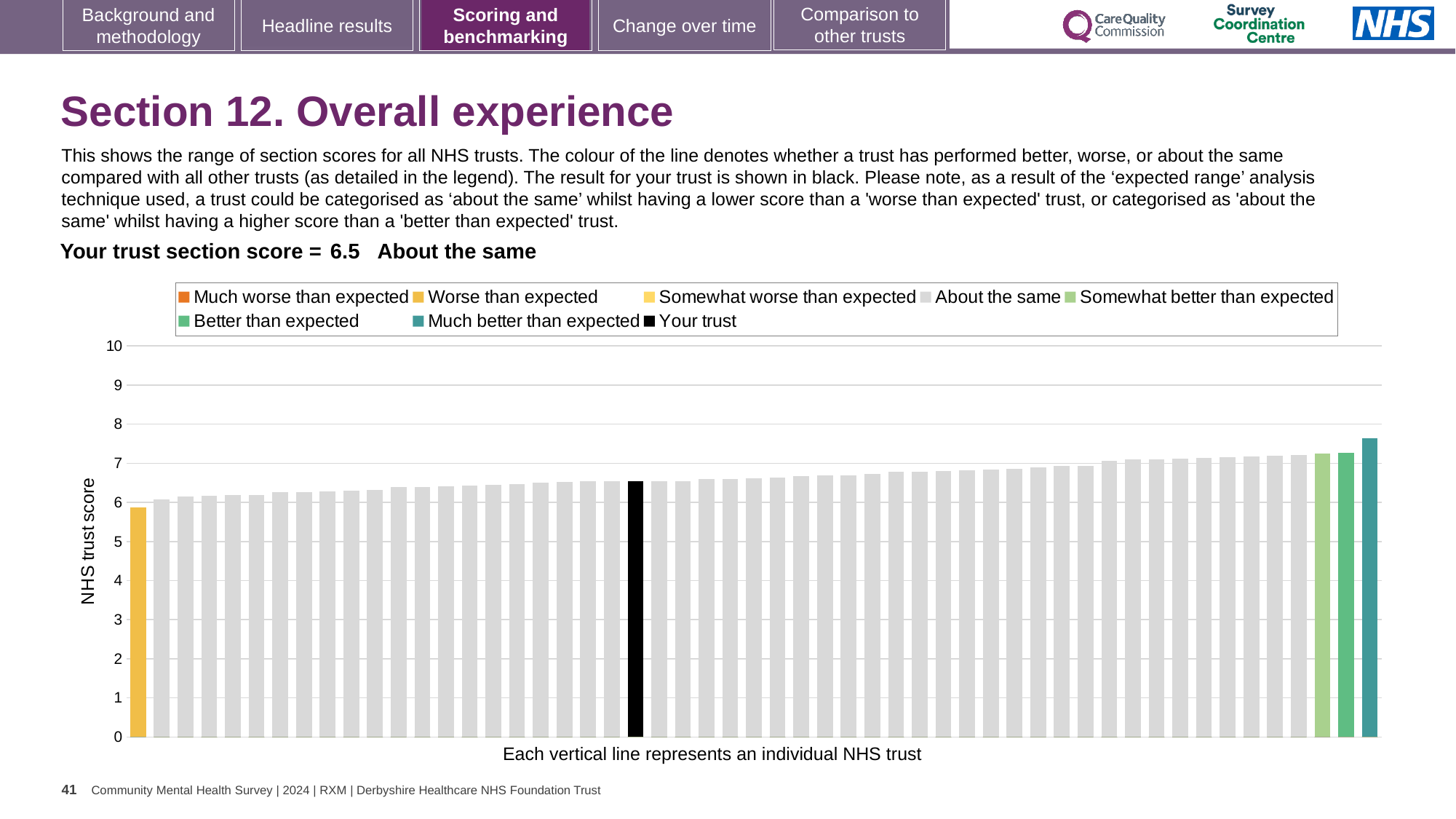
What is the section score for your trust shown on the slide? 6.5 Which performance category is your trust placed in for Section 12? About the same Do the bar values rise or fall moving from left to right along the x axis? rise Is the value of the tallest bar (the rightmost trust) greater or less than 8? less What colour is the bar representing your trust? black What is the label on the vertical axis of the chart? NHS trust score Which legend category does the highest-scoring trust belong to? Much better than expected Is the value of the shortest bar (the leftmost trust) greater or less than 5? greater How many entries does the chart legend list? 8 Is the value of the tallest bar (the rightmost trust) greater or less than 7? greater Which is larger: the score of your trust or the score of the rightmost trust? the rightmost trust What kind of chart is shown on the slide? bar chart